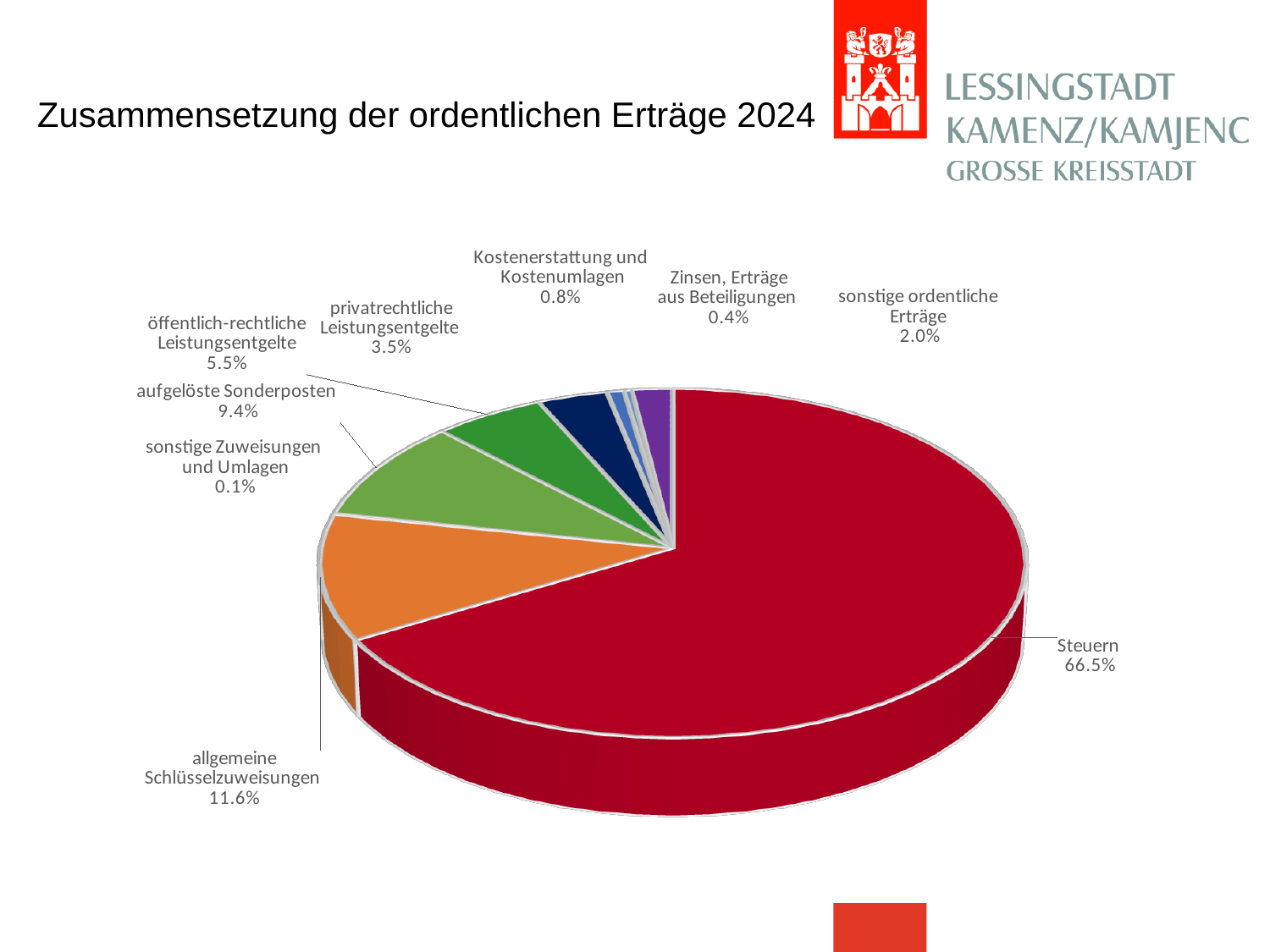
What percentage is shown for Zinsen, Erträge aus Beteiligungen? 0.4% What percentage is shown for öffentlich-rechtliche Leistungsentgelte? 5.5% What percentage is shown for aufgelöste Sonderposten? 9.4% Which category has the largest share of the pie? Steuern What kind of chart is shown on the slide? pie chart What share of the ordinary revenues comes from Steuern? 66.5% What percentage is shown for allgemeine Schlüsselzuweisungen? 11.6% What is the difference in percentage points between allgemeine Schlüsselzuweisungen and aufgelöste Sonderposten? 2.2 How many categories are shown in the pie chart? 9 Which is larger: privatrechtliche Leistungsentgelte or sonstige ordentliche Erträge? privatrechtliche Leistungsentgelte Which category has the smallest share of the pie? sonstige Zuweisungen und Umlagen What is the title of the slide? Zusammensetzung der ordentlichen Erträge 2024